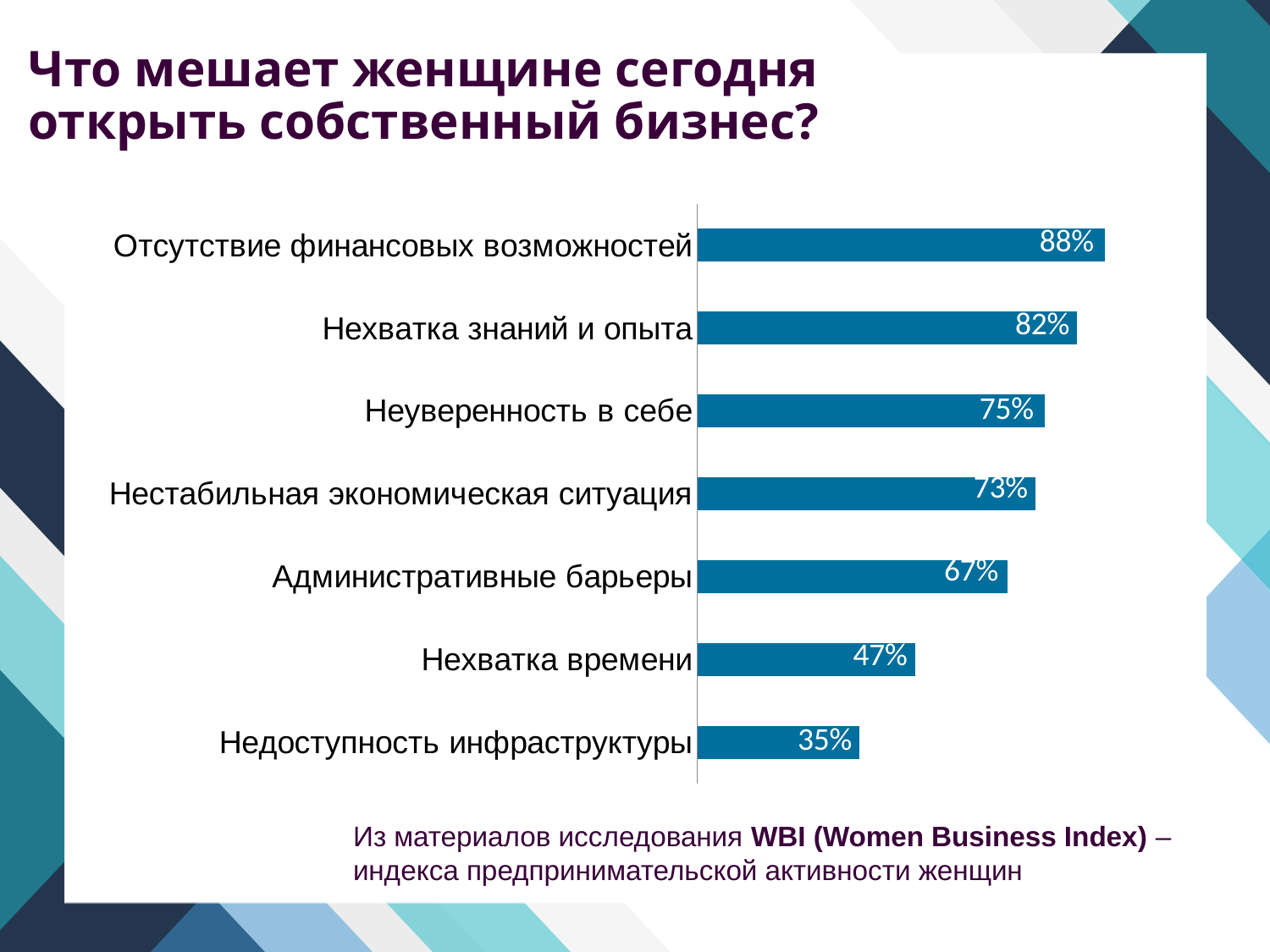
Which is larger: «Нестабильная экономическая ситуация» or «Административные барьеры»? Нестабильная экономическая ситуация What is the value for «Нехватка знаний и опыта»? 82% What kind of chart is shown on the slide? Bar chart Which category has the lowest value? Недоступность инфраструктуры What is the title of the slide containing the chart? Что мешает женщине сегодня открыть собственный бизнес? What is the difference between «Неуверенность в себе» and «Нехватка времени»? 28% What is the value for «Недоступность инфраструктуры»? 35% Which category has the highest value? Отсутствие финансовых возможностей What is the difference between «Отсутствие финансовых возможностей» and «Недоступность инфраструктуры»? 53% How many categories are shown in the chart? 7 What is the value for «Отсутствие финансовых возможностей»? 88% What is the value for «Административные барьеры»? 67%